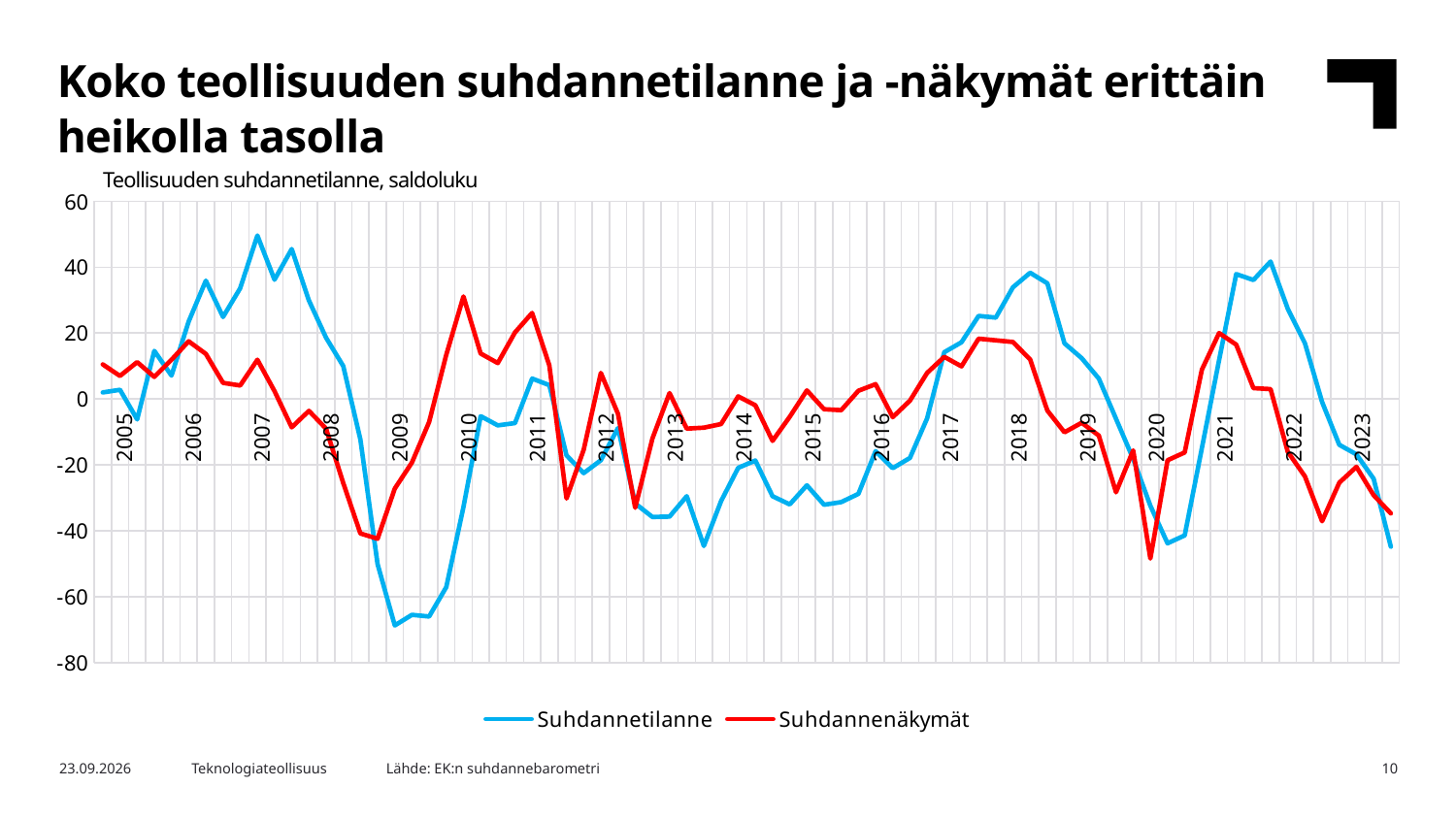
What are the two series named in the legend? Suhdannetilanne and Suhdannenäkymät Is the lowest value of the Suhdannenäkymät line, reached around 2020, greater or less than -40? less How many series does the legend list? 2 Is the peak of the Suhdannenäkymät line around 2010 greater or less than 20? greater Which series reaches the higher maximum value over the whole period, Suhdannetilanne or Suhdannenäkymät? Suhdannetilanne What is the title printed above the chart? Teollisuuden suhdannetilanne, saldoluku Which series reaches the lower minimum value over the whole period, Suhdannetilanne or Suhdannenäkymät? Suhdannetilanne Is the lowest value of the Suhdannetilanne line, reached around 2009, greater or less than -60? less Does the Suhdannetilanne line rise or fall from its 2021 peak to the end of 2023? fall What kind of chart is shown on the slide? line chart